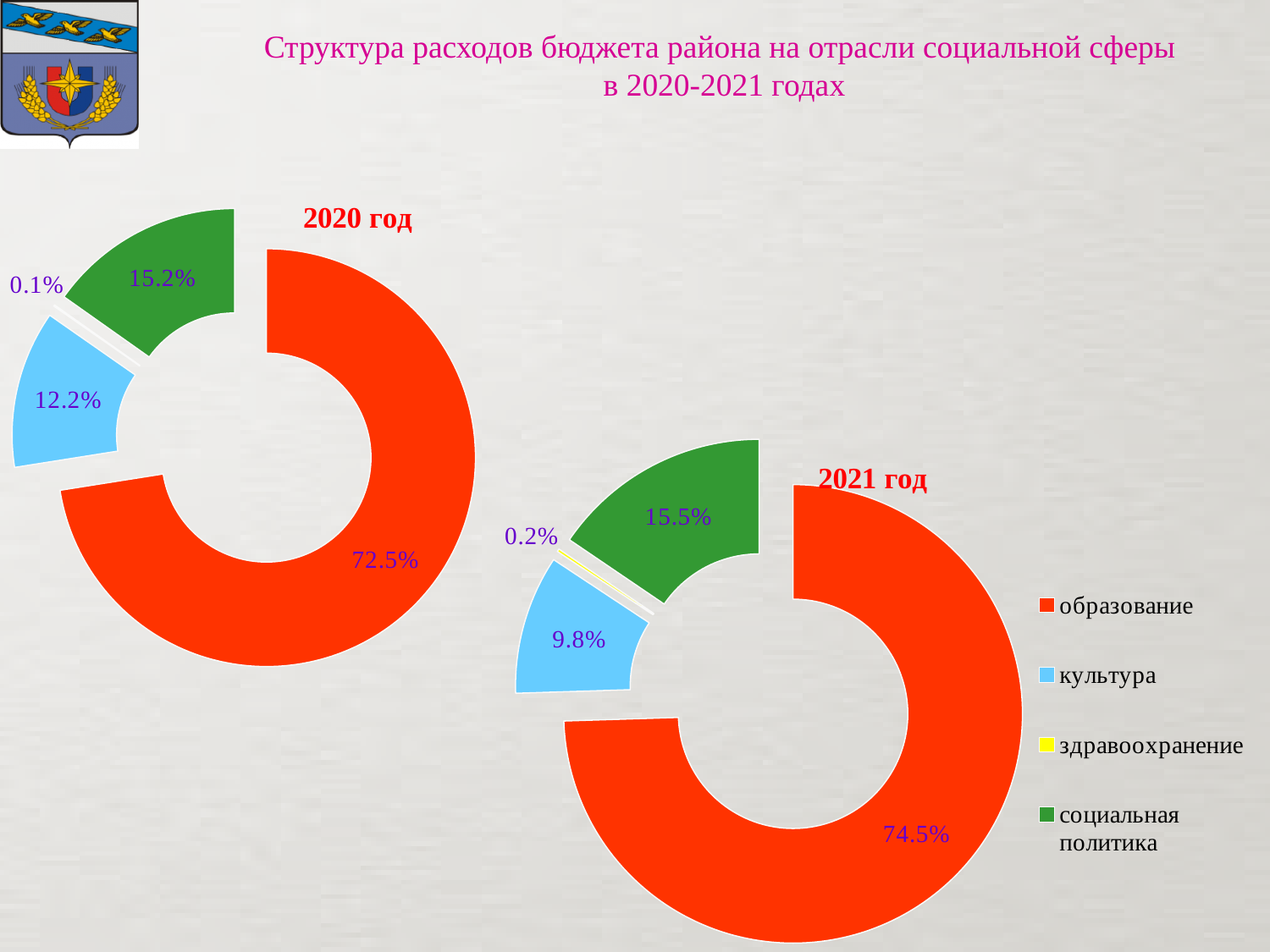
In the 2021 год chart, what share is shown for культура? 9.8% What is the difference between the share of образование in 2021 год and in 2020 год? 2.0% How many categories does the legend list? 4 In the 2020 год chart, which category has the smallest share? здравоохранение What type of chart is used for the 2020 год data? Doughnut (pie) chart Which is larger: the share of культура in the 2020 год chart or in the 2021 год chart? 2020 год In the 2020 год chart, what share is shown for социальная политика? 15.2% In the 2020 год chart, what share is shown for образование? 72.5% Which colour represents здравоохранение in the legend? Yellow In the 2021 год chart, which category has the largest share? образование In the 2021 год chart, what share is shown for здравоохранение? 0.2% In the 2020 год chart, what is the difference between the shares of социальная политика and культура? 3.0%